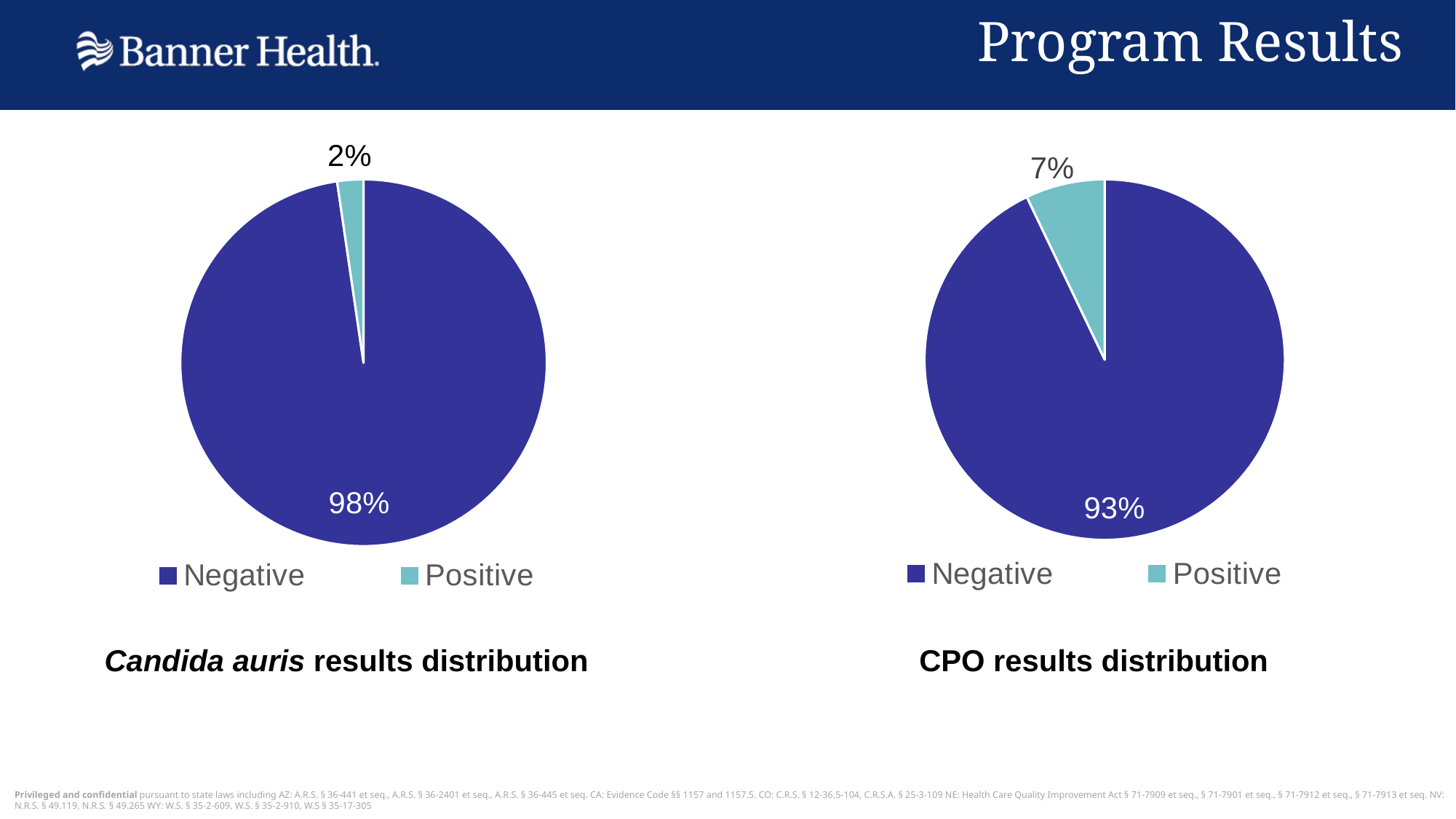
What share of the pie does the Positive slice take in the Candida auris results distribution chart? 2% In the CPO results distribution chart, what percentage of results were Negative? 93% What type of chart is the Candida auris results distribution chart? Pie chart What are the two legend entries in the CPO results distribution chart? Negative and Positive In the CPO results distribution chart, what percentage of results were Positive? 7% In the Candida auris results distribution chart, what percentage of results were Negative? 98% In the Candida auris results distribution chart, what percentage of results were Positive? 2% How many categories does the CPO results distribution chart show? 2 What is the difference between the Negative and Positive shares in the CPO results distribution chart? 86% Which chart shows a larger Positive share, the Candida auris results distribution chart or the CPO results distribution chart? CPO results distribution In the CPO results distribution chart, which category has the largest slice? Negative In the Candida auris results distribution chart, which category has the smallest slice? Positive